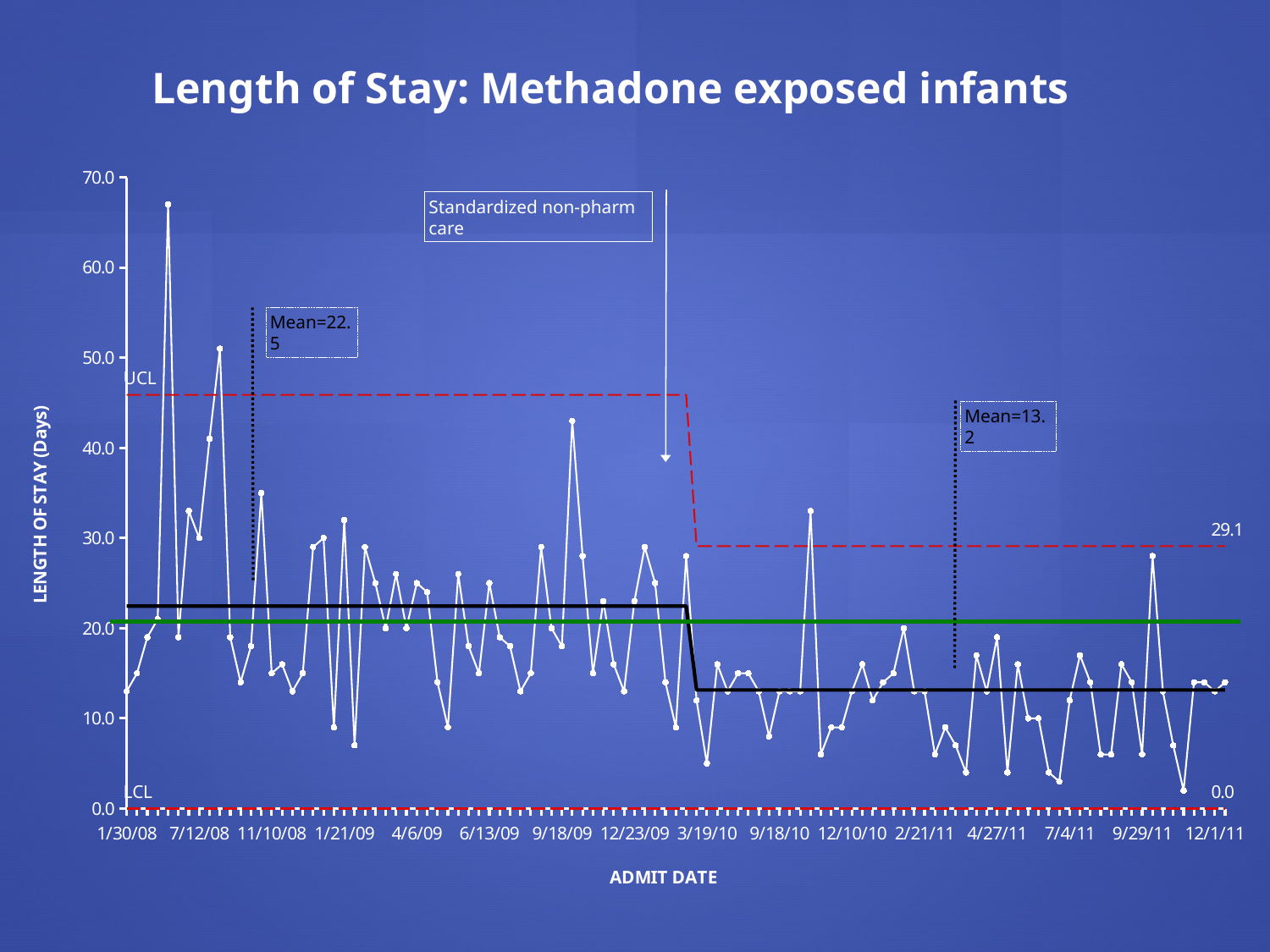
Is the highest plotted length of stay (the peak shortly after 1/30/08) greater or less than 60? greater What is the title of the chart? Length of Stay: Methadone exposed infants What value is printed at the right end of the upper control limit (UCL) line? 29.1 Overall, do the plotted length-of-stay values rise or fall from the left of the x axis to the right? Fall What is the difference between the two annotated means, 22.5 and 13.2? 9.3 What kind of chart is shown on the slide? Line chart What mean value is annotated for the earlier period of the chart (before the intervention)? Mean=22.5 What is the label of the y axis? LENGTH OF STAY (Days) What value is printed at the right end of the lower control limit (LCL) line? 0.0 What mean value is annotated for the later period of the chart (after the intervention)? Mean=13.2 Which annotated mean is larger, the earlier period mean or the later period mean? The earlier period mean (22.5)